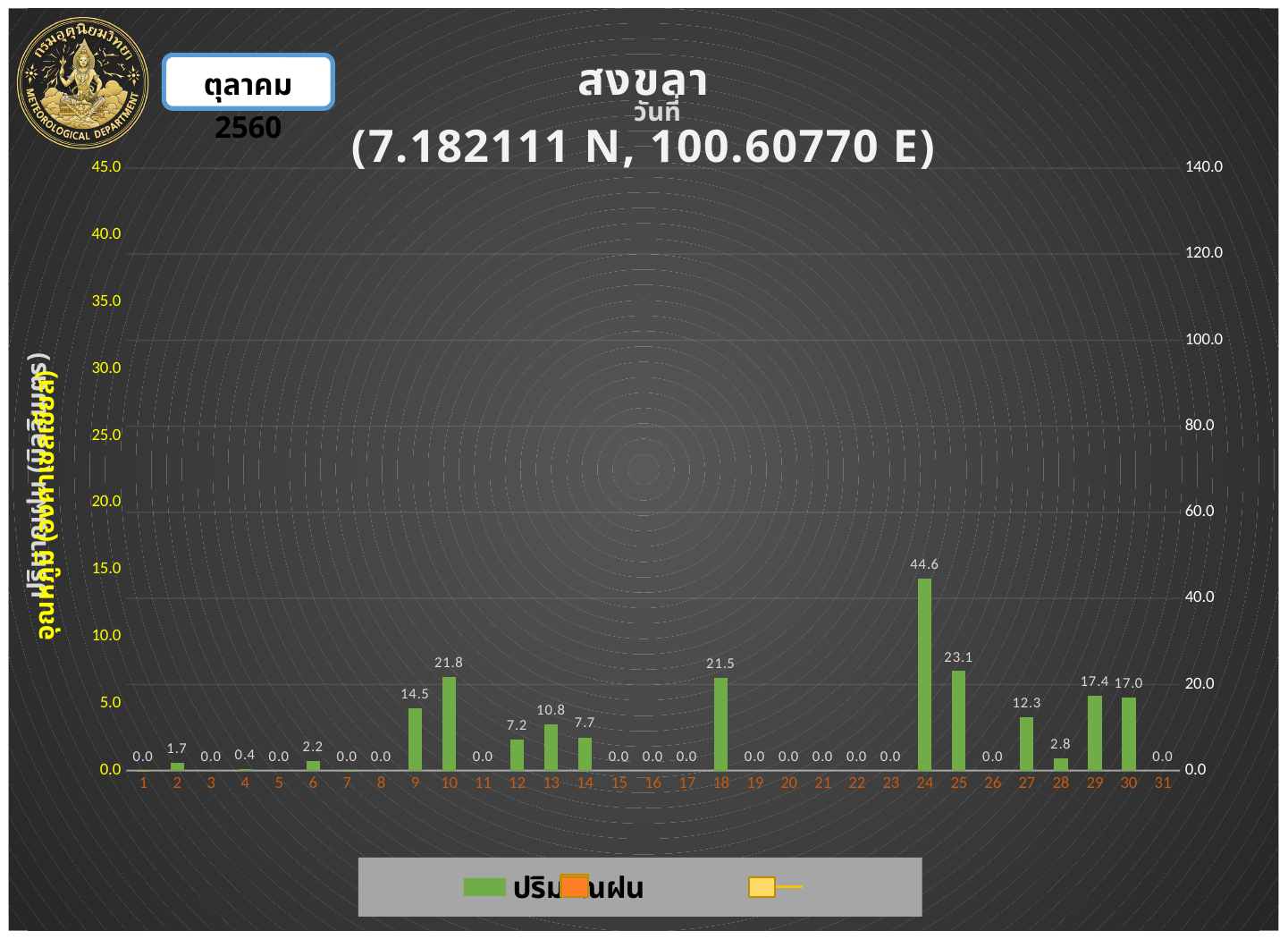
How many days are shown on the x axis? 31 Which day has the highest rainfall value? 24 What is the difference between the rainfall values for day 9 and day 12? 7.3 Which has the larger rainfall value, day 27 or day 30? day 30 What is the difference between the rainfall values for day 24 and day 25? 21.5 What is the main title of the chart? สงขลา (7.182111 N, 100.60770 E) What is the rainfall value shown for day 24? 44.6 What is the rainfall value shown for day 13? 10.8 What is the rainfall value shown for day 29? 17.4 What is the rainfall value shown for day 10? 21.8 Which has the larger rainfall value, day 10 or day 18? day 10 What kind of chart is shown on the slide? bar chart